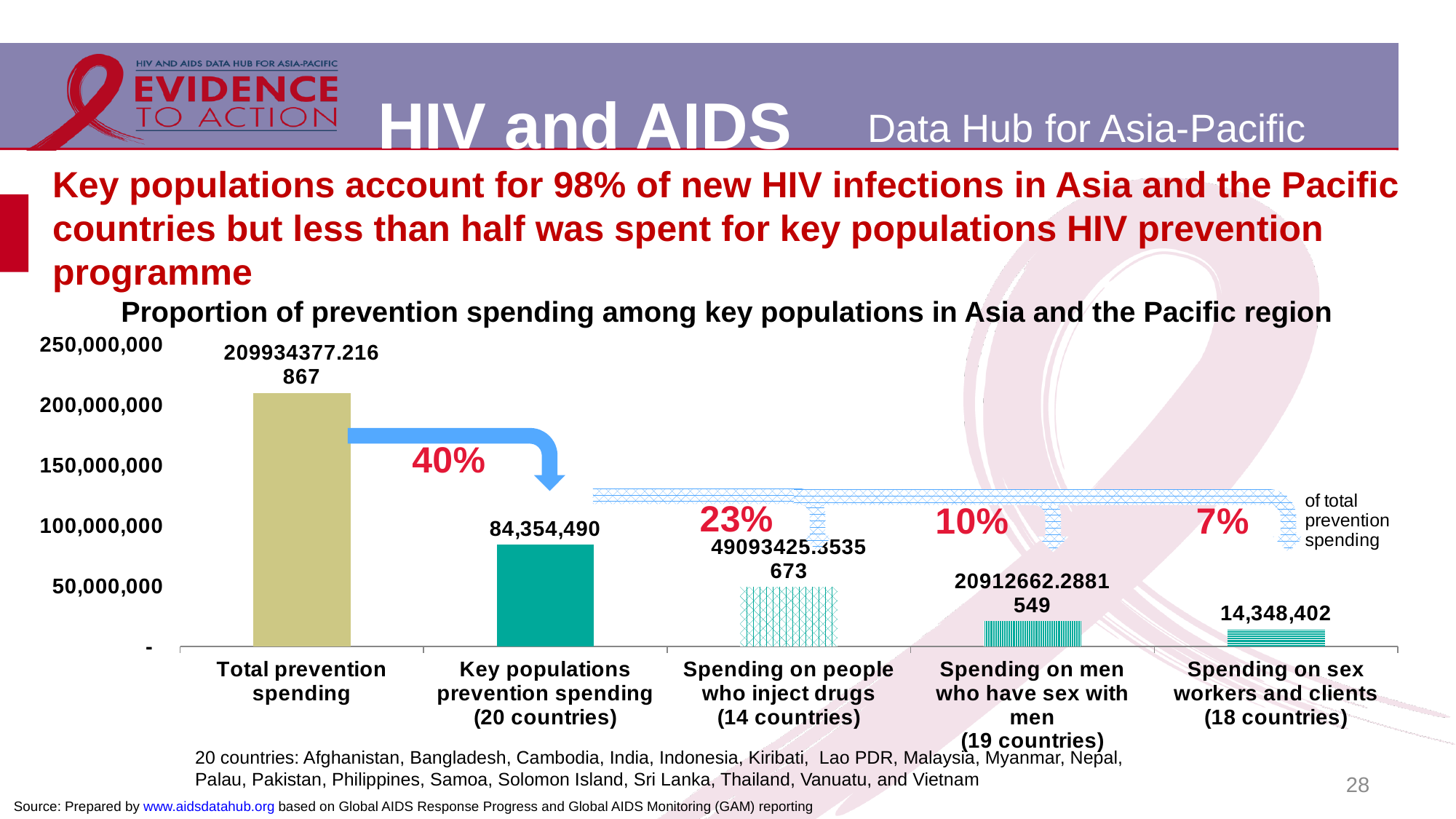
Is the value for Key populations prevention spending greater or less than 100,000,000? less Which category has the highest value? Total prevention spending What is the value for Spending on sex workers and clients (18 countries)? 14,348,402 What is the difference between Key populations prevention spending and Spending on sex workers and clients? 70,006,088 Is the value for Total prevention spending greater or less than 200,000,000? greater What is the value for Key populations prevention spending (20 countries)? 84,354,490 What kind of chart is shown on the slide? bar chart What percentage of total prevention spending is shown for Key populations prevention spending? 40% Which category has the lowest value? Spending on sex workers and clients (18 countries) Which is larger: Key populations prevention spending or Spending on sex workers and clients? Key populations prevention spending How many categories are plotted on the chart? 5 What is the value for Spending on men who have sex with men (19 countries)? 20912662.2881549